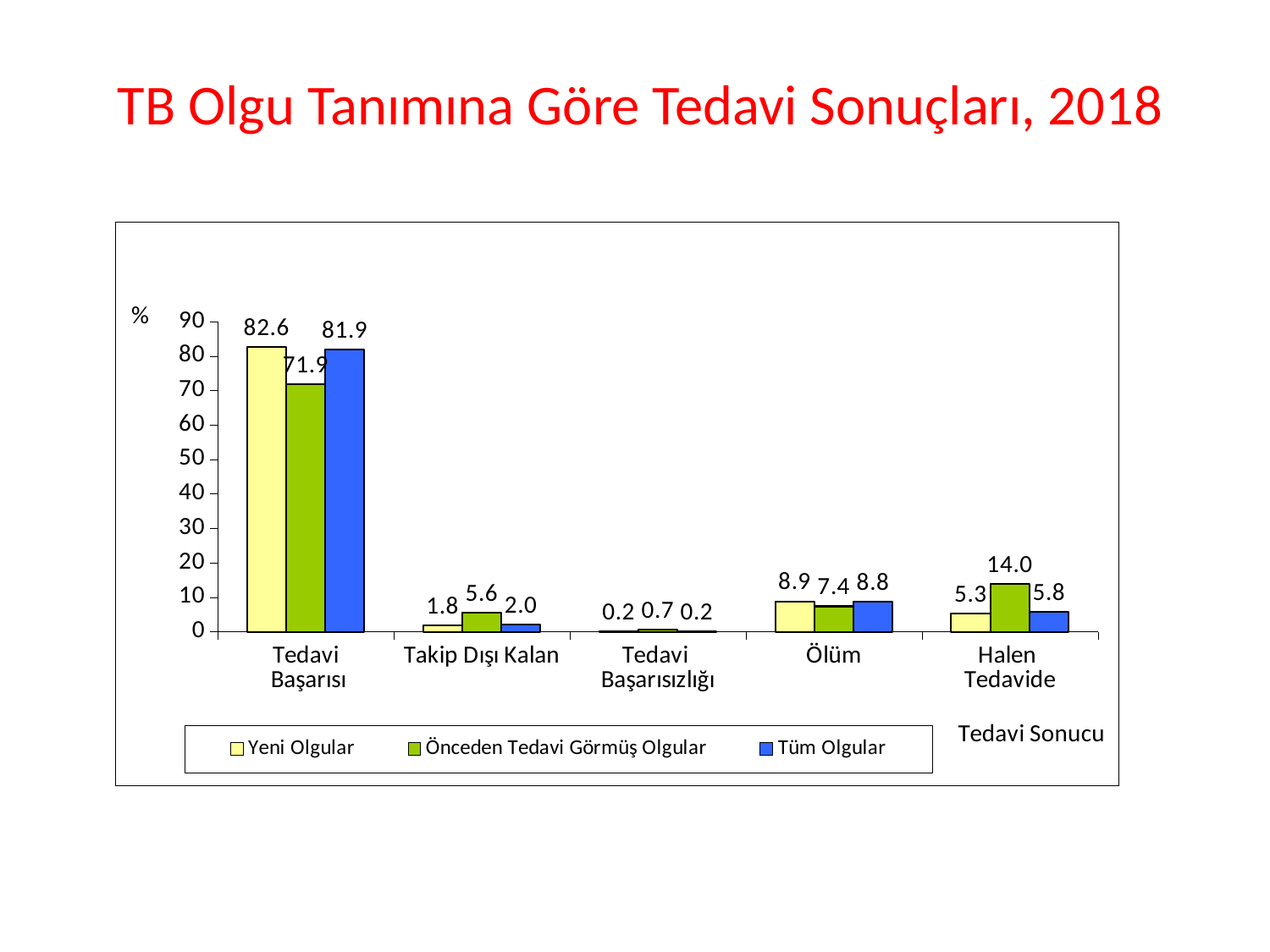
Is the value for Tüm Olgular in the Tedavi Başarısı category greater or less than 80? greater What is the value for Önceden Tedavi Görmüş Olgular in the Takip Dışı Kalan category? 5.6 What kind of chart is shown on the slide? bar chart What is the difference between the Yeni Olgular and Önceden Tedavi Görmüş Olgular values in the Tedavi Başarısı category? 10.7 What is the value for Tüm Olgular in the Ölüm category? 8.8 In the Halen Tedavide category, which series has the larger value: Yeni Olgular or Önceden Tedavi Görmüş Olgular? Önceden Tedavi Görmüş Olgular Which category has the highest value for Tüm Olgular? Tedavi Başarısı How many series does the legend list? 3 How many categories are shown on the x axis? 5 What is the value for Yeni Olgular in the Tedavi Başarısı category? 82.6 Which category has the lowest value for Yeni Olgular? Tedavi Başarısızlığı What is the value for Önceden Tedavi Görmüş Olgular in the Halen Tedavide category? 14.0